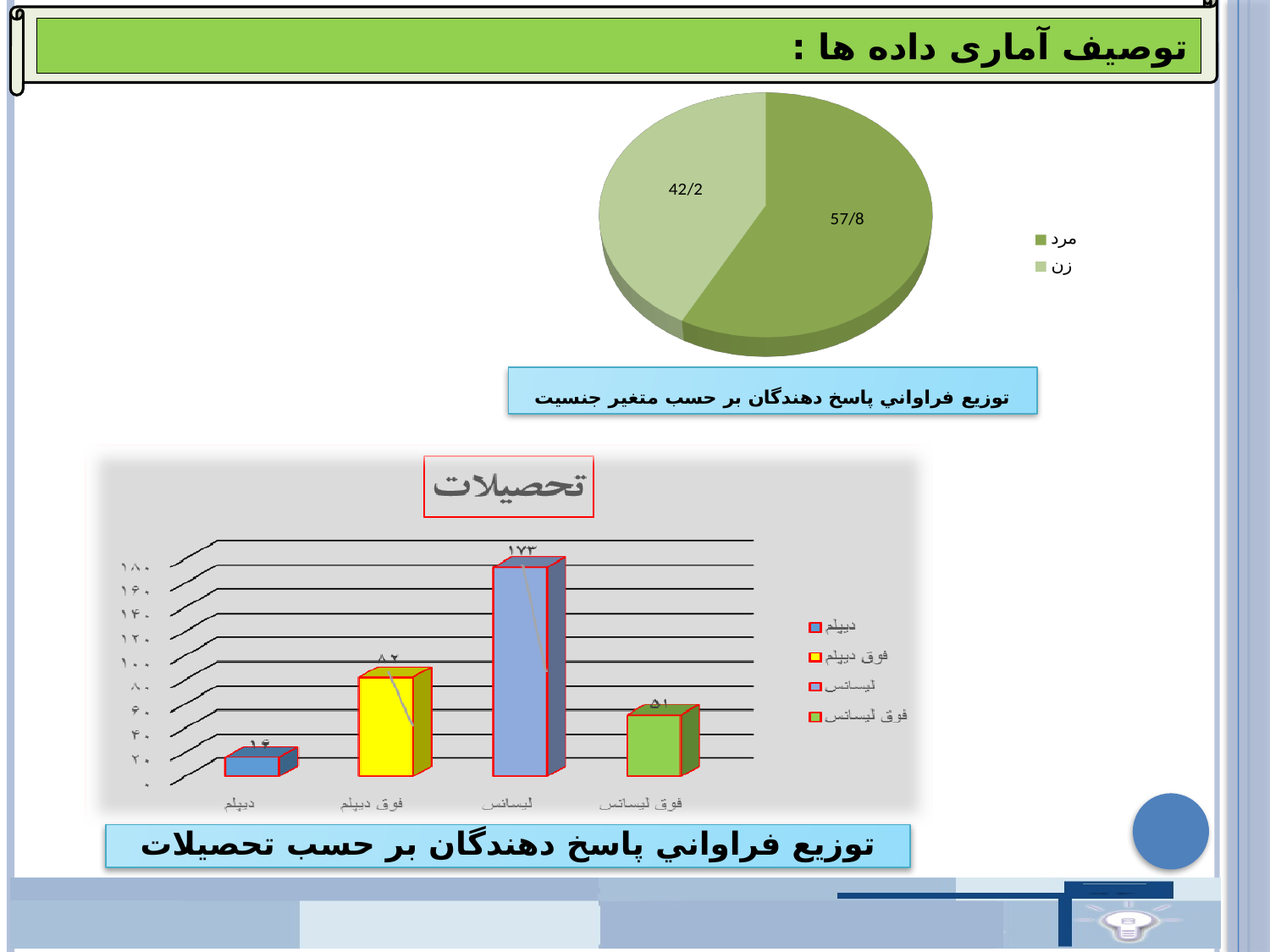
In the bar chart titled تحصیلات, is the value for دیپلم greater or less than ۲۰? less In the bar chart titled تحصیلات, which category has the lowest value? دیپلم In the pie chart at the top of the slide, what value is shown for the زن slice? 42/2 In the pie chart at the top of the slide, what value is shown for the مرد slice? 57/8 In the bar chart titled تحصیلات, what is the value for فوق دیپلم? ۸۲ In the pie chart at the top of the slide, how many slices are there? 2 In the bar chart titled تحصیلات, what is the value for فوق لیسانس? ۵۱ In the bar chart titled تحصیلات, which category has the highest value? لیسانس In the bar chart titled تحصیلات, what is the value for لیسانس? ۱۷۳ In the bar chart titled تحصیلات, how many entries does the legend list? 4 In the pie chart at the top of the slide, which category has the larger slice? مرد What type of chart is the top chart on the slide? pie chart